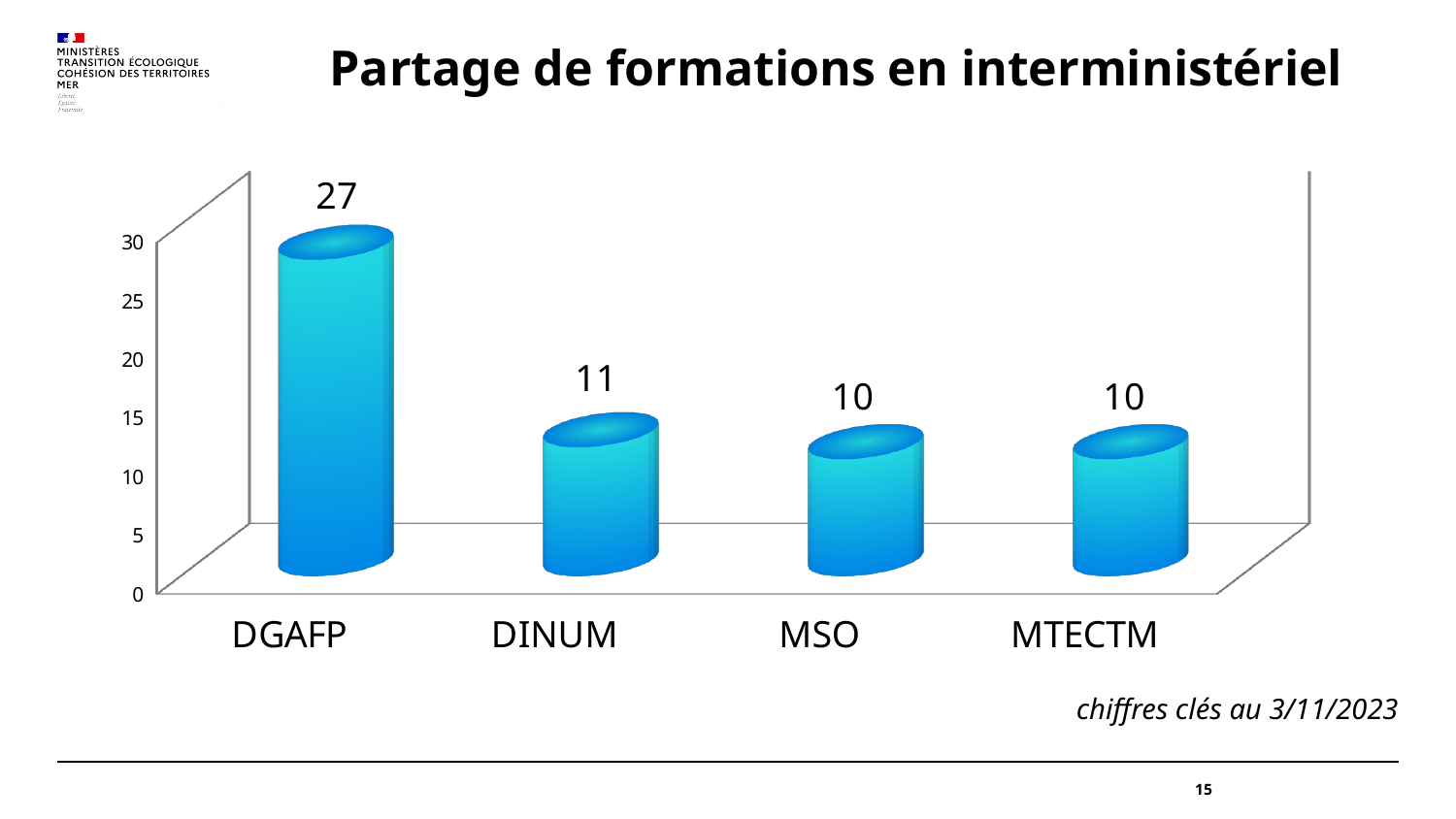
Is the value for DGAFP greater or less than 20? greater What is the difference between the values for DINUM and MSO? 1 What is the value for DINUM? 11 What is the value for DGAFP? 27 How many categories are shown on the chart? 4 What kind of chart is shown on the slide? bar chart What is the title of the chart? Partage de formations en interministériel What is the value for MSO? 10 Which category has the highest value? DGAFP What is the difference between the values for DGAFP and DINUM? 16 Which is larger, the value for DGAFP or the value for MTECTM? DGAFP What is the value for MTECTM? 10